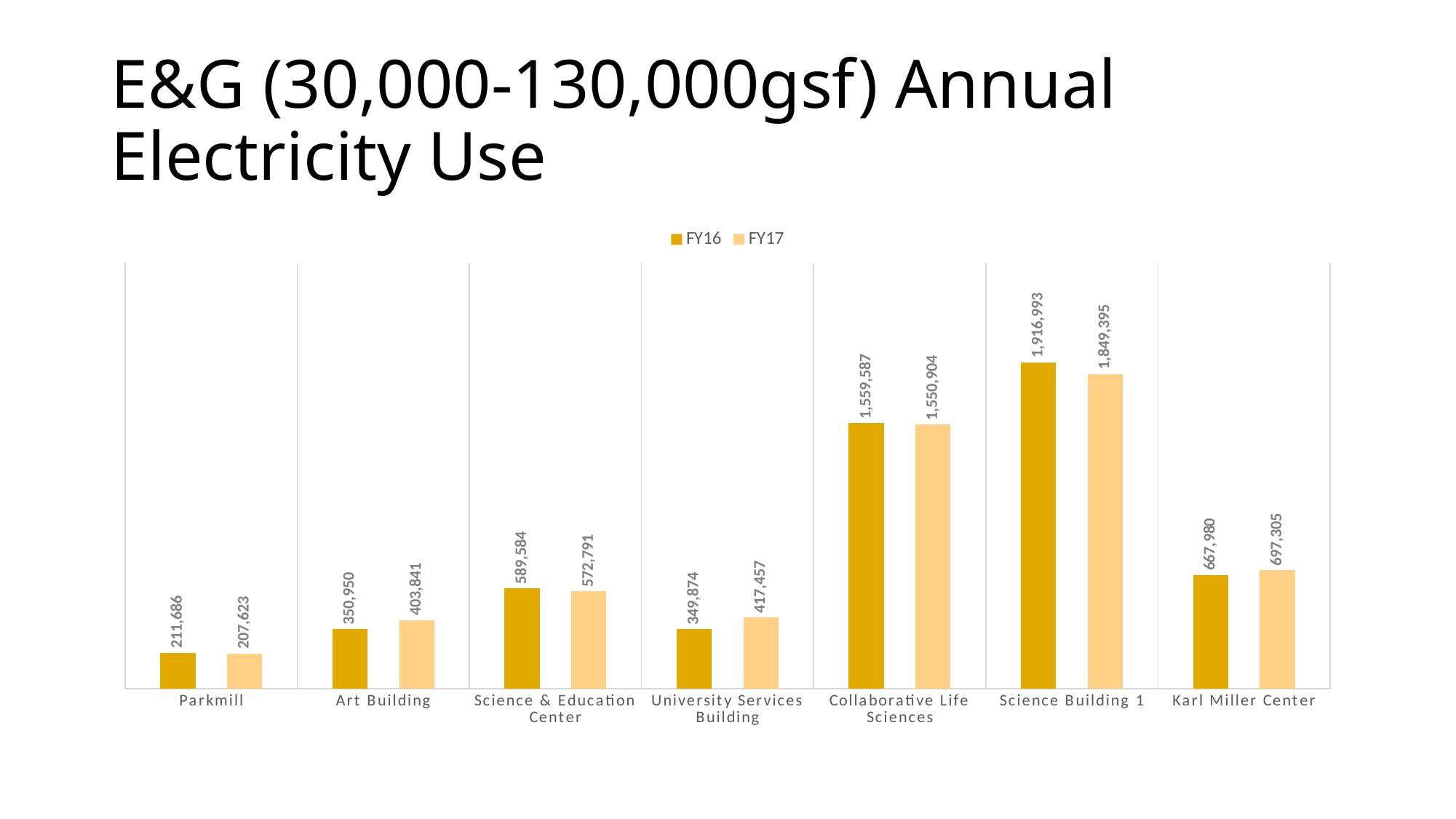
Which building has the highest FY16 electricity use? Science Building 1 What is the FY17 value for Collaborative Life Sciences? 1,550,904 How many buildings are shown on the x axis? 7 How many series does the legend list? 2 What is the difference between the FY17 and FY16 values for the Art Building? 52,891 By how much did Science Building 1's electricity use decrease from FY16 to FY17? 67,598 What is the FY17 electricity use for the Art Building? 403,841 Which is larger for the University Services Building, the FY16 value or the FY17 value? FY17 What is the FY16 value for Karl Miller Center? 667,980 Which building has the lowest FY17 electricity use? Parkmill What is the FY16 electricity use for Parkmill? 211,686 What kind of chart is shown on the slide? Bar chart